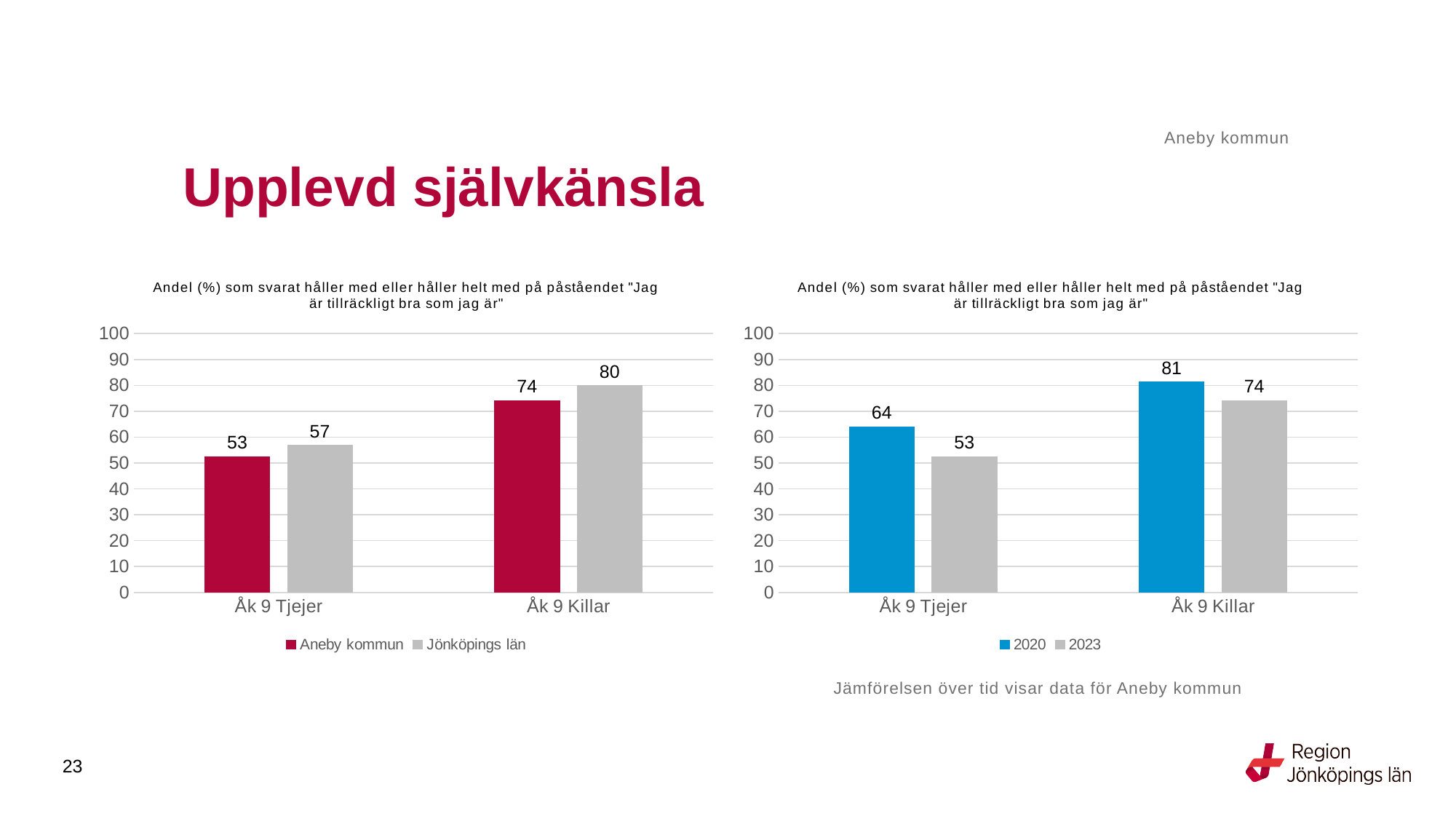
In the right chart, which is larger for Åk 9 Killar: 2020 or 2023? 2020 In the left chart, what is the difference between Jönköpings län and Aneby kommun for Åk 9 Killar? 6 What kind of chart is the left chart? Bar chart In the left chart, what is the value for Aneby kommun for Åk 9 Tjejer? 53 In the right chart, which bar has the lowest value? 2023 for Åk 9 Tjejer In the right chart, what is the difference between the 2020 and 2023 values for Åk 9 Tjejer? 11 In the left chart, which category has the highest value for Aneby kommun? Åk 9 Killar In the left chart, what is the value for Jönköpings län for Åk 9 Killar? 80 In the right chart, what is the value for 2023 for Åk 9 Tjejer? 53 What are the legend entries of the left chart? Aneby kommun, Jönköpings län How many series does the legend of the right chart list? 2 In the right chart, what is the value for 2020 for Åk 9 Killar? 81